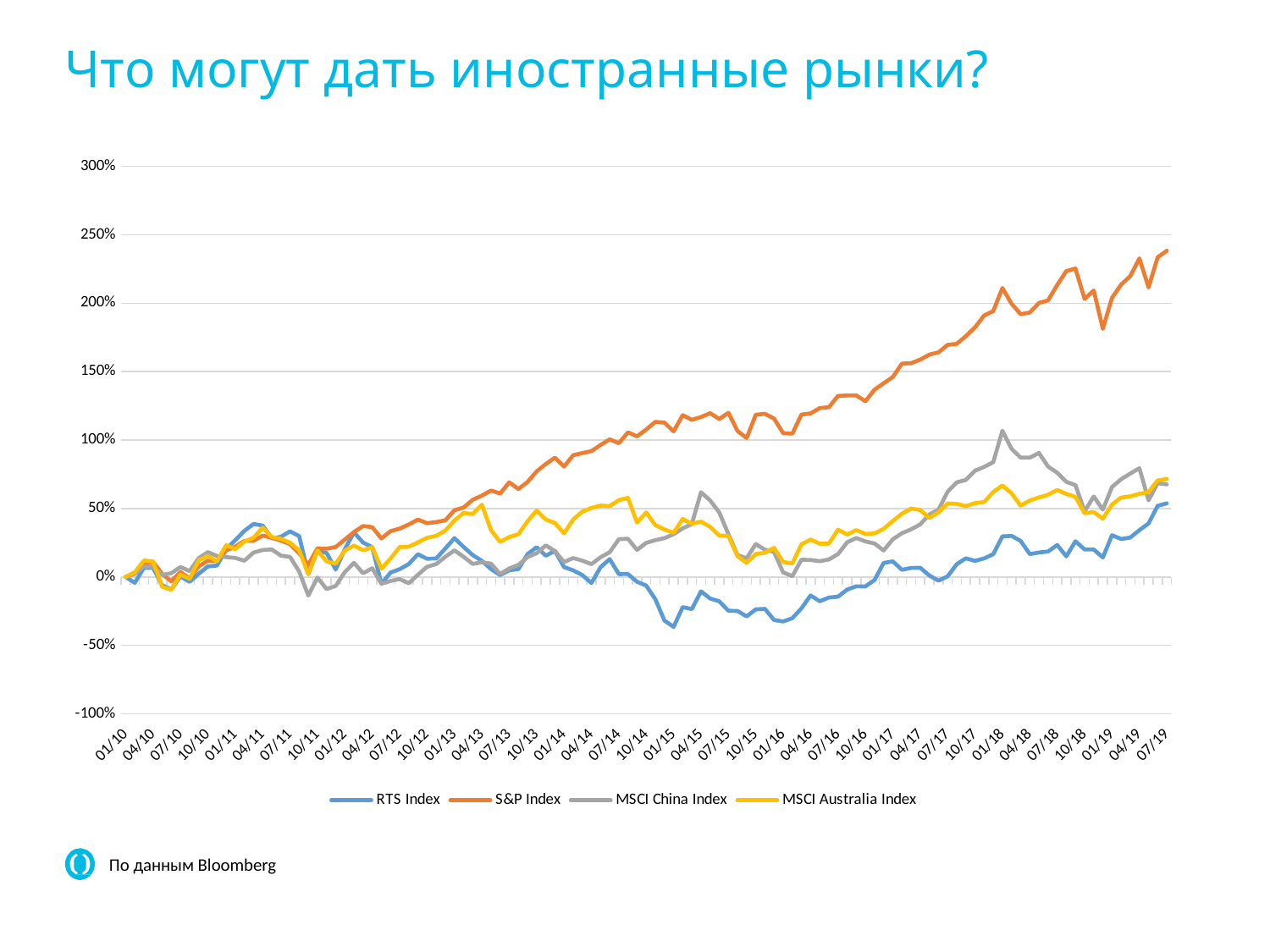
Does the S&P Index generally rise or fall from 01/10 to 07/19? rise Is the value of the MSCI China Index at 01/18 greater or less than 50%? greater Is the value of the RTS Index at 01/15 greater or less than 0%? less What colour is the line for the S&P Index? orange At 07/19, which is larger: the S&P Index or the RTS Index? S&P Index Which series has the lowest value around 01/15? RTS Index Is the value of the S&P Index at 07/19 greater or less than 200%? greater What kind of chart is shown on the slide? line chart What is the title of the slide? Что могут дать иностранные рынки? How many series does the legend list? 4 Which series reaches the highest value at the end of the chart (07/19)? S&P Index